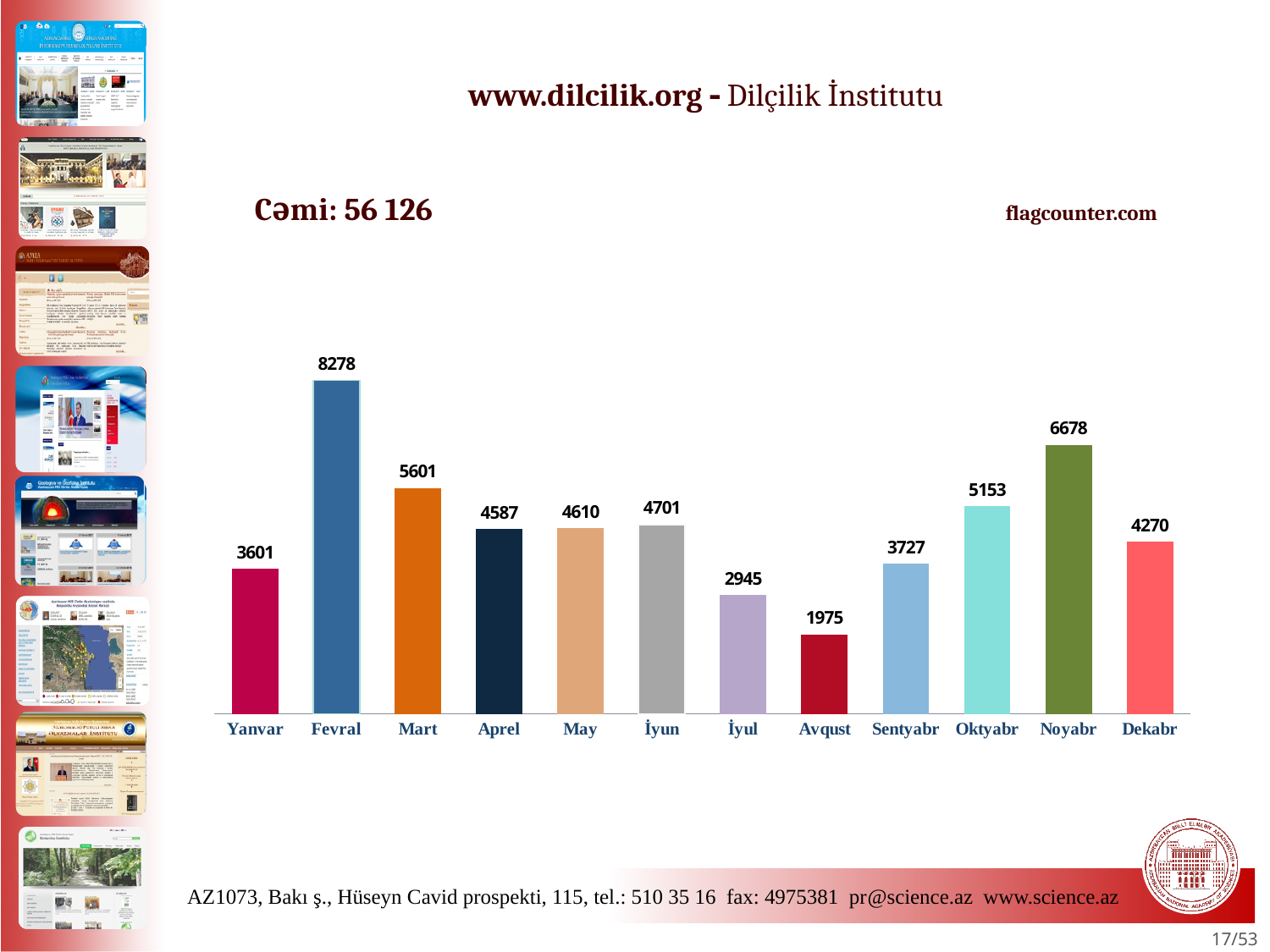
Which is larger, the value for Oktyabr or the value for Sentyabr? Oktyabr Which month has the highest value? Fevral What is the value for Avqust? 1975 How many months are shown on the chart? 12 What total (Cəmi) is stated on the slide? 56 126 What kind of chart is shown on the slide? Bar chart Which month has the lowest value? Avqust What is the value for Noyabr? 6678 What is the difference between the values for Fevral and Mart? 2677 What is the difference between the values for Noyabr and Dekabr? 2408 What is the value for Fevral? 8278 Which is larger, the value for İyun or the value for İyul? İyun